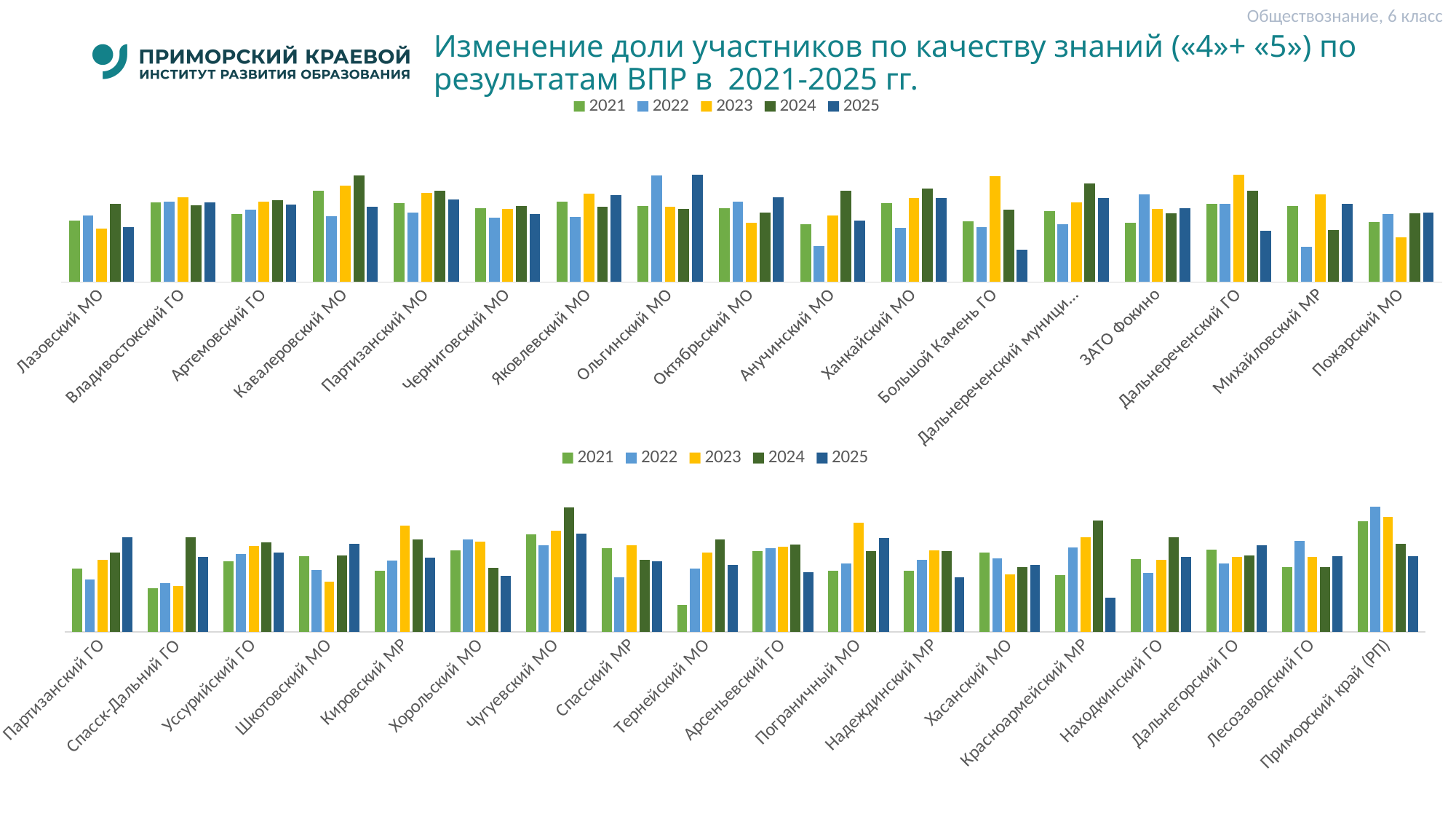
In the top chart, which year has the lowest bar for Большой Камень ГО? 2025 How many series does the legend of the top chart list? 5 In the bottom chart, which year has the lowest bar for Тернейский МО? 2021 How many categories are shown on the x axis of the bottom chart? 18 In the top chart, which year has the highest bar for Большой Камень ГО? 2023 In the top chart, which year has the lowest bar for Михайловский МР? 2022 In the bottom chart, for Приморский край (РП), is the 2022 bar or the 2025 bar taller? 2022 In the bottom chart, which year has the highest bar for Чугуевский МО? 2024 What kind of chart is the top chart on the slide? bar chart How many categories are shown on the x axis of the top chart? 17 Which years are listed in the legend of the bottom chart? 2021, 2022, 2023, 2024, 2025 In the bottom chart, for Красноармейский МР, is the 2024 bar or the 2025 bar taller? 2024